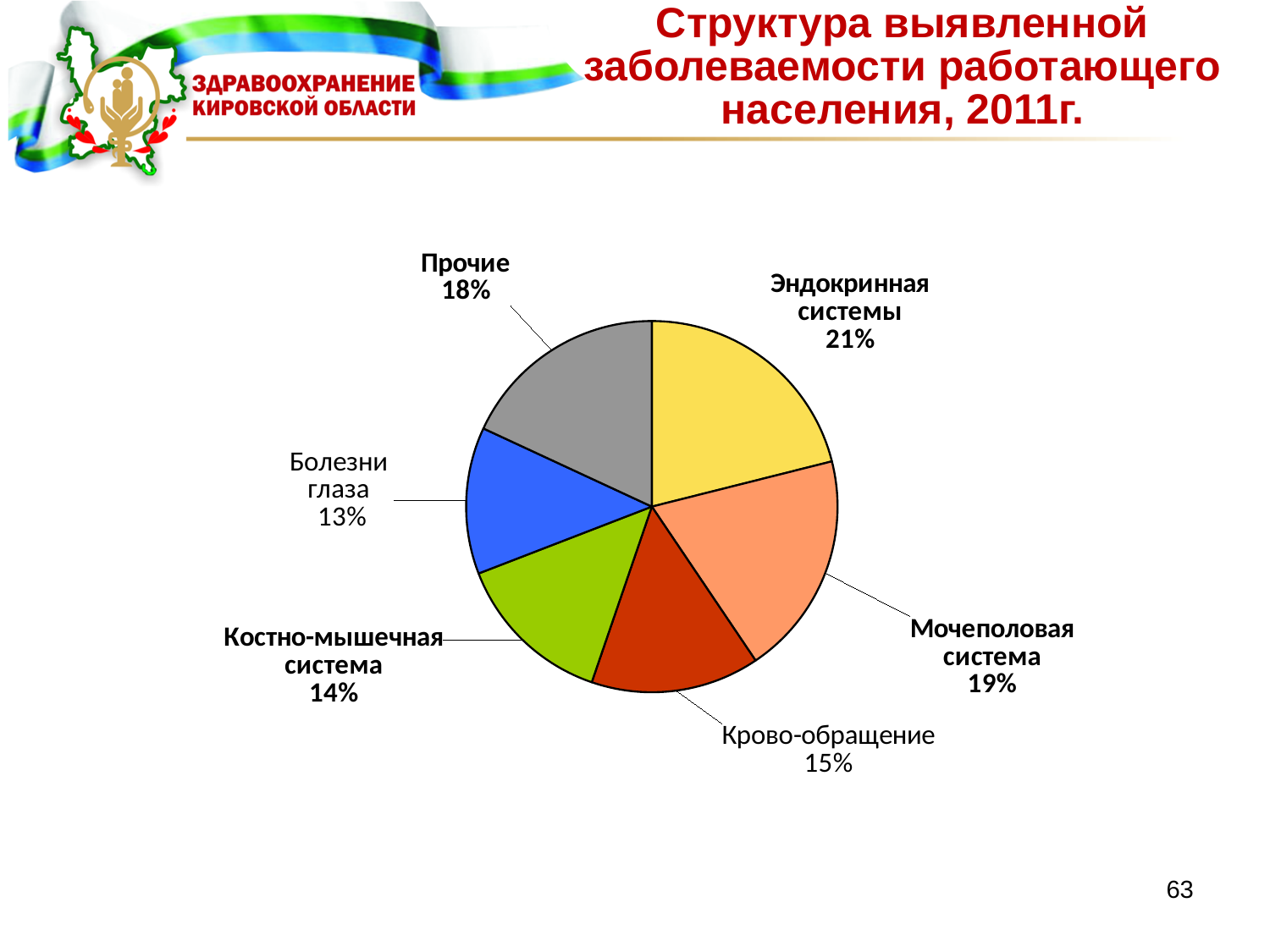
What is the difference in percentage points between Эндокринная системы and Болезни глаза? 8 What share of the pie does Костно-мышечная система have? 14% What share of the pie does Мочеполовая система have? 19% How many categories (slices) does the pie chart have? 6 Which category has the smallest share of the pie? Болезни глаза What share of the pie does Крово-обращение have? 15% Which is larger: the share for Прочие or the share for Крово-обращение? Прочие Which category has the largest share of the pie? Эндокринная системы What type of chart is shown on the slide? pie chart